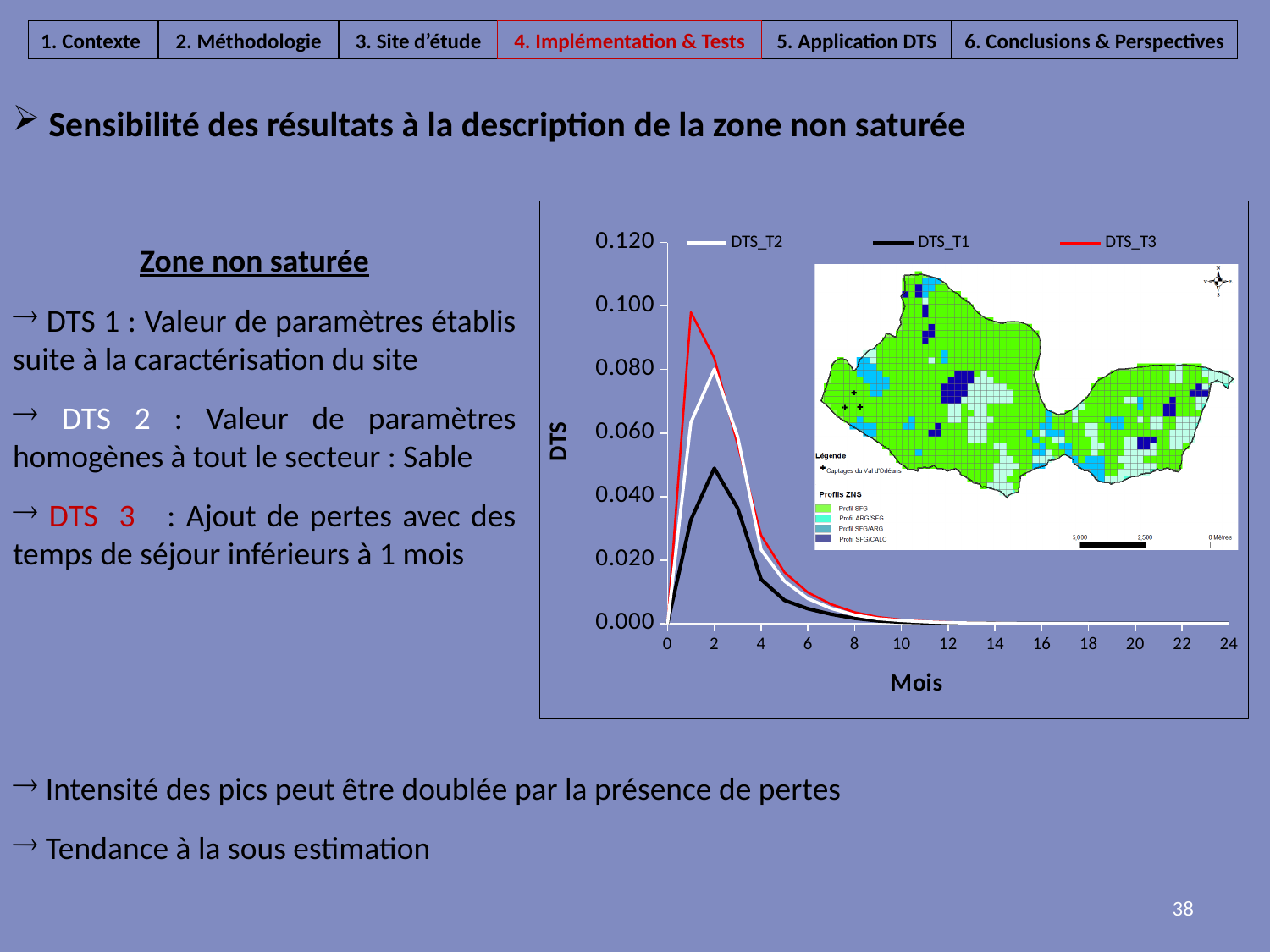
What is the label of the x axis of the chart? Mois What kind of chart is shown on the slide? line chart How many series does the chart legend list? 3 Is the peak value of DTS_T1 greater or less than 0.060? less What are the names of the series listed in the chart legend? DTS_T2, DTS_T1, DTS_T3 Which series has the lowest peak value in the chart? DTS_T1 Is the peak value of DTS_T3 greater or less than 0.080? greater After their peaks, do the DTS values rise or fall as the months increase? fall Which series reaches the highest peak value in the chart? DTS_T3 Is the peak value of DTS_T2 greater or less than 0.060? greater Which series has a higher peak, DTS_T2 or DTS_T1? DTS_T2 What is the highest tick value shown on the x axis (Mois)? 24